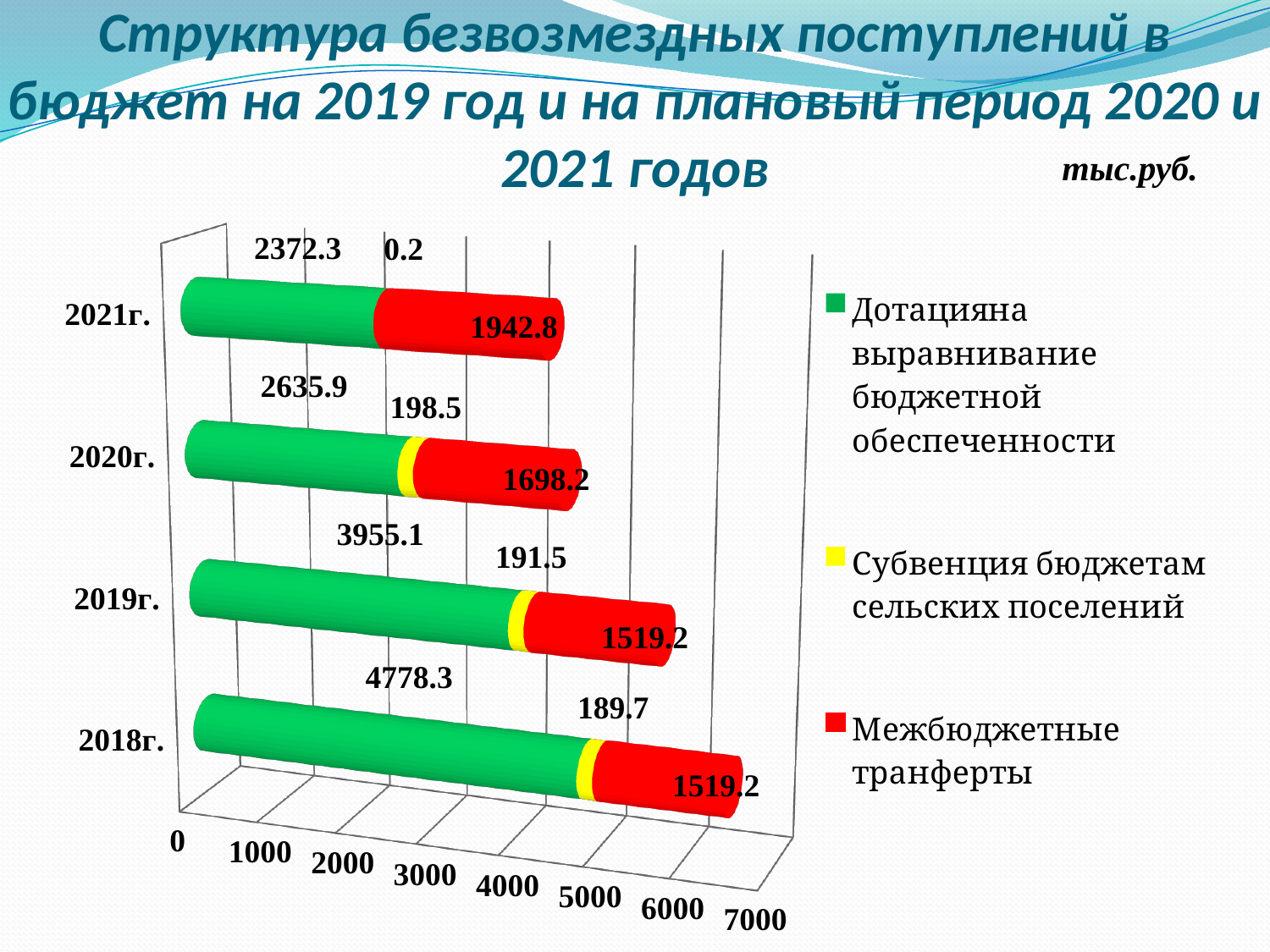
Which year has the highest value for Дотация на выравнивание бюджетной обеспеченности? 2018г. What is the total of the stacked bar for 2018г.? 6487.2 What kind of chart is shown on the slide? Stacked bar chart What is the value of Межбюджетные трансферты for 2021г.? 1942.8 What is the total of the stacked bar for 2021г.? 4315.3 How many years are shown on the chart? 4 Which year has the lowest value for Субвенция бюджетам сельских поселений? 2021г. How many series does the legend list? 3 What is the value of Дотация на выравнивание бюджетной обеспеченности for 2018г.? 4778.3 What is the difference between the Дотация на выравнивание бюджетной обеспеченности values for 2019г. and 2020г.? 1319.2 What is the value of Субвенция бюджетам сельских поселений for 2020г.? 198.5 Which is larger: Межбюджетные трансферты for 2020г. or for 2019г.? 2020г.